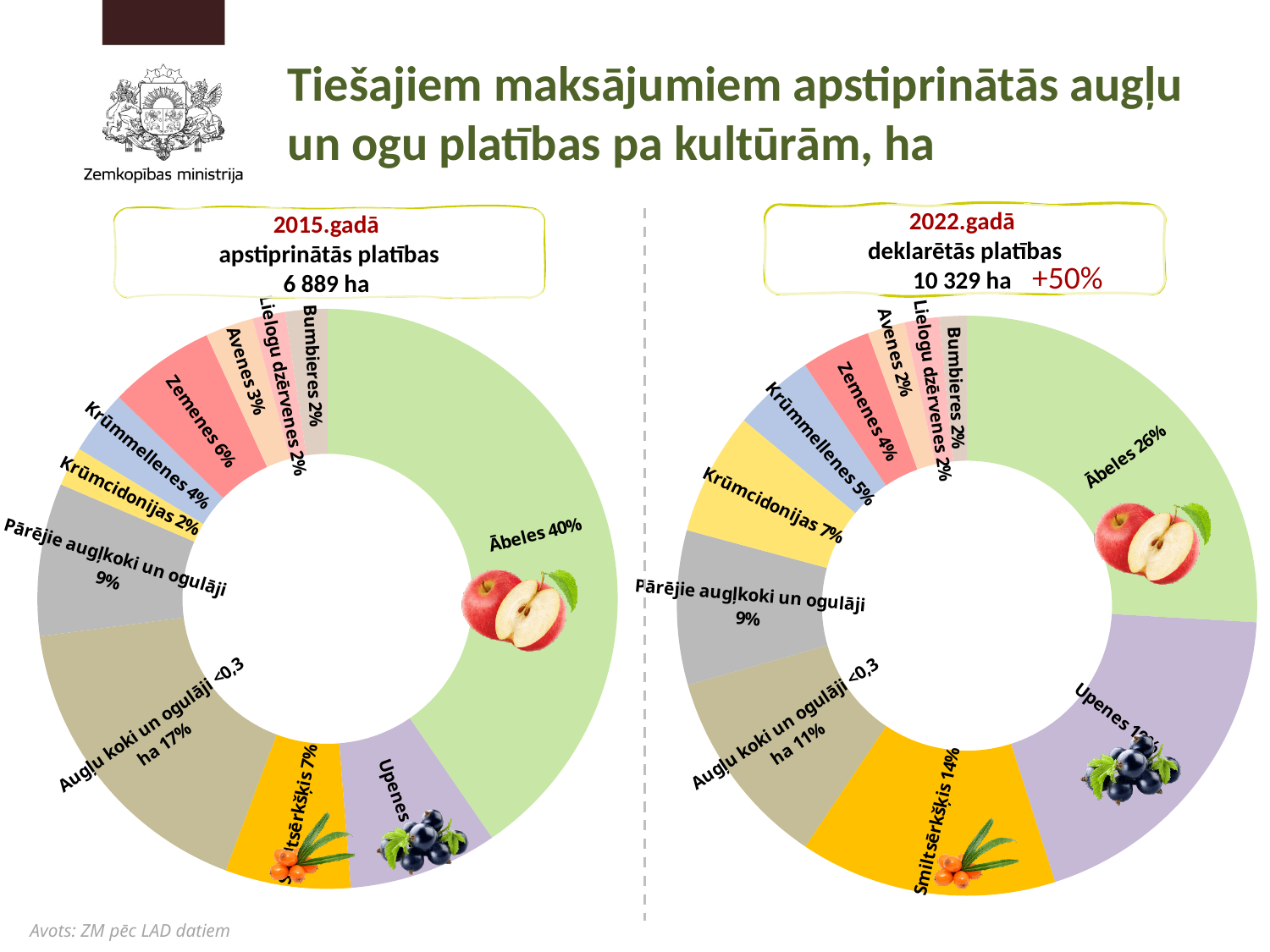
What is the difference between the Ābeles share in the 2015.gadā chart and in the 2022.gadā chart? 14 percentage points What kind of chart is used on the slide for the 2015 and 2022 data? Pie (doughnut) chart In the 2022.gadā chart, what share do Ābeles have? 26% In the 2022.gadā chart, what share does Smiltsērkšķis have? 14% In the 2015.gadā chart, what share do Zemenes have? 6% In the 2022.gadā chart, which category has the largest share? Ābeles In the 2015.gadā chart, which category has the largest share? Ābeles How many categories are shown in the 2015.gadā chart? 11 In the 2022.gadā chart, what share do Krūmcidonijas have? 7% In the 2022.gadā chart, which is larger: Krūmmellenes or Zemenes? Krūmmellenes In the 2015.gadā chart, what share do Ābeles have? 40% What total declared area is stated above the 2022.gadā chart? 10 329 ha